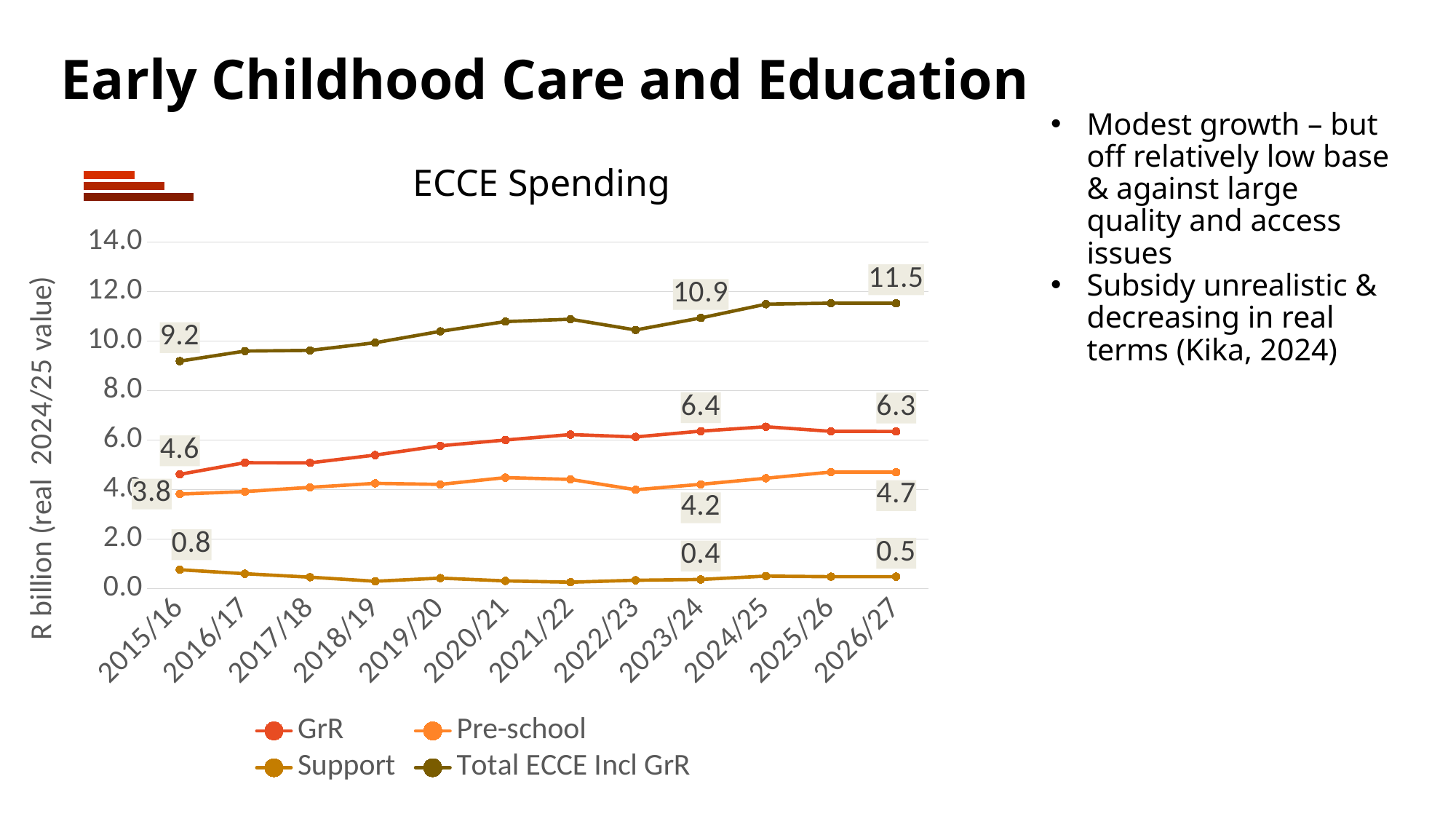
What type of chart is the ECCE Spending chart? line chart What is the value for Support in 2026/27? 0.5 How many fiscal years are shown on the x axis of the ECCE Spending chart? 12 What is the value for Total ECCE Incl GrR in 2026/27? 11.5 What is the value for GrR in 2023/24? 6.4 By how much did Total ECCE Incl GrR increase from 2015/16 to 2026/27? 2.3 Which is larger in 2023/24, GrR or Pre-school? GrR Is the value for Total ECCE Incl GrR in 2020/21 greater or less than 10.0? greater How many series does the legend of the ECCE Spending chart list? 4 Which series has the lowest values across all years in the ECCE Spending chart? Support Does the Total ECCE Incl GrR series generally rise or fall from 2015/16 to 2026/27? rise What is the value for Pre-school in 2015/16? 3.8